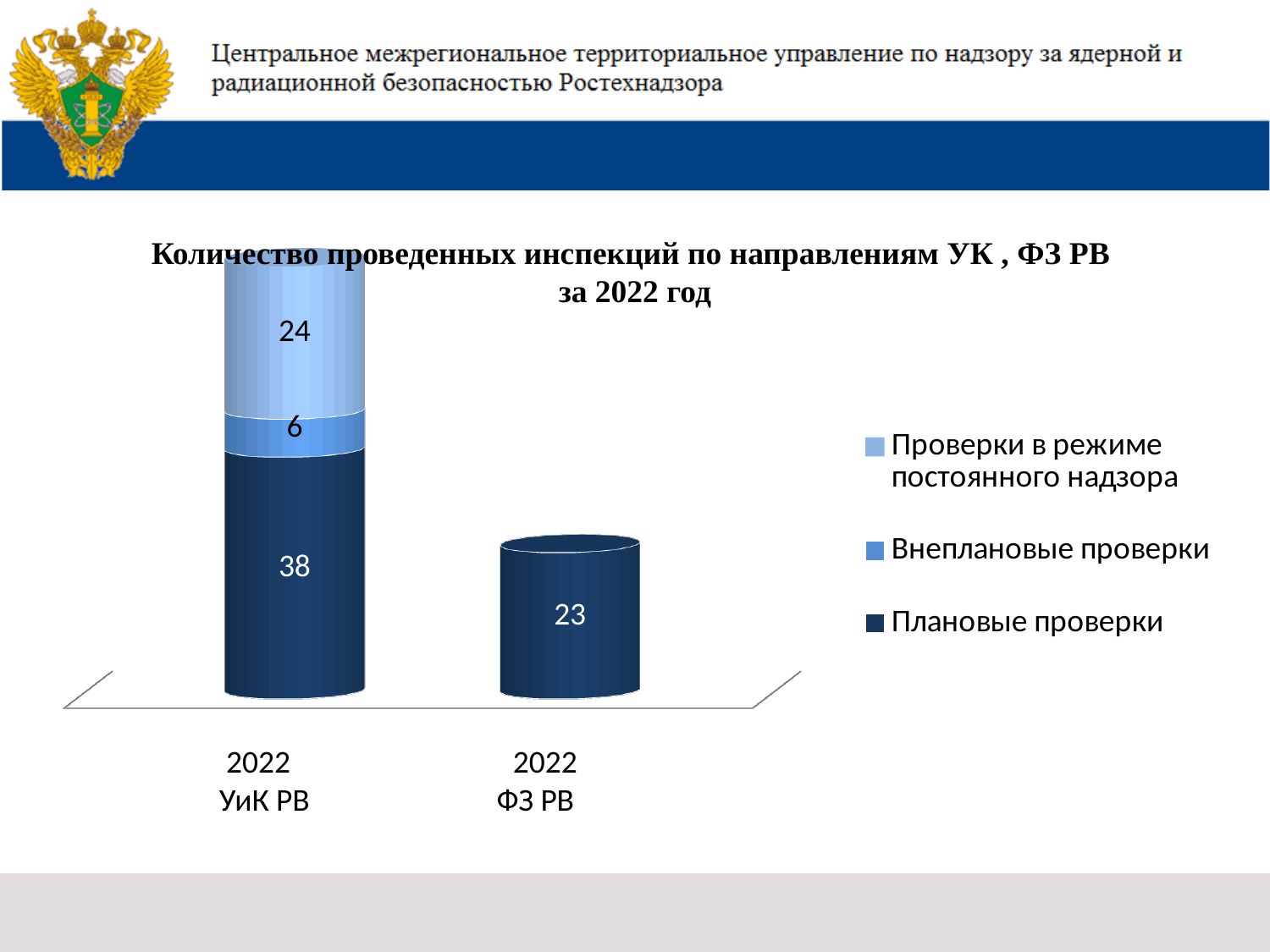
What is the value of Внеплановые проверки for 2022 УиК РВ? 6 What kind of chart is shown on the slide? Stacked bar chart Which category has the higher value of Плановые проверки, 2022 УиК РВ or 2022 ФЗ РВ? 2022 УиК РВ What is the difference between Плановые проверки for 2022 УиК РВ and for 2022 ФЗ РВ? 15 What is the value of Плановые проверки for 2022 УиК РВ? 38 Which series has the lowest value in the 2022 УиК РВ bar? Внеплановые проверки How many categories are shown on the x axis of the chart? 2 What is the value of Проверки в режиме постоянного надзора for 2022 УиК РВ? 24 How many series does the legend list? 3 What is the total of the stacked bar for 2022 УиК РВ? 68 What is the value of Плановые проверки for 2022 ФЗ РВ? 23 Which series has the highest value in the 2022 УиК РВ bar? Плановые проверки